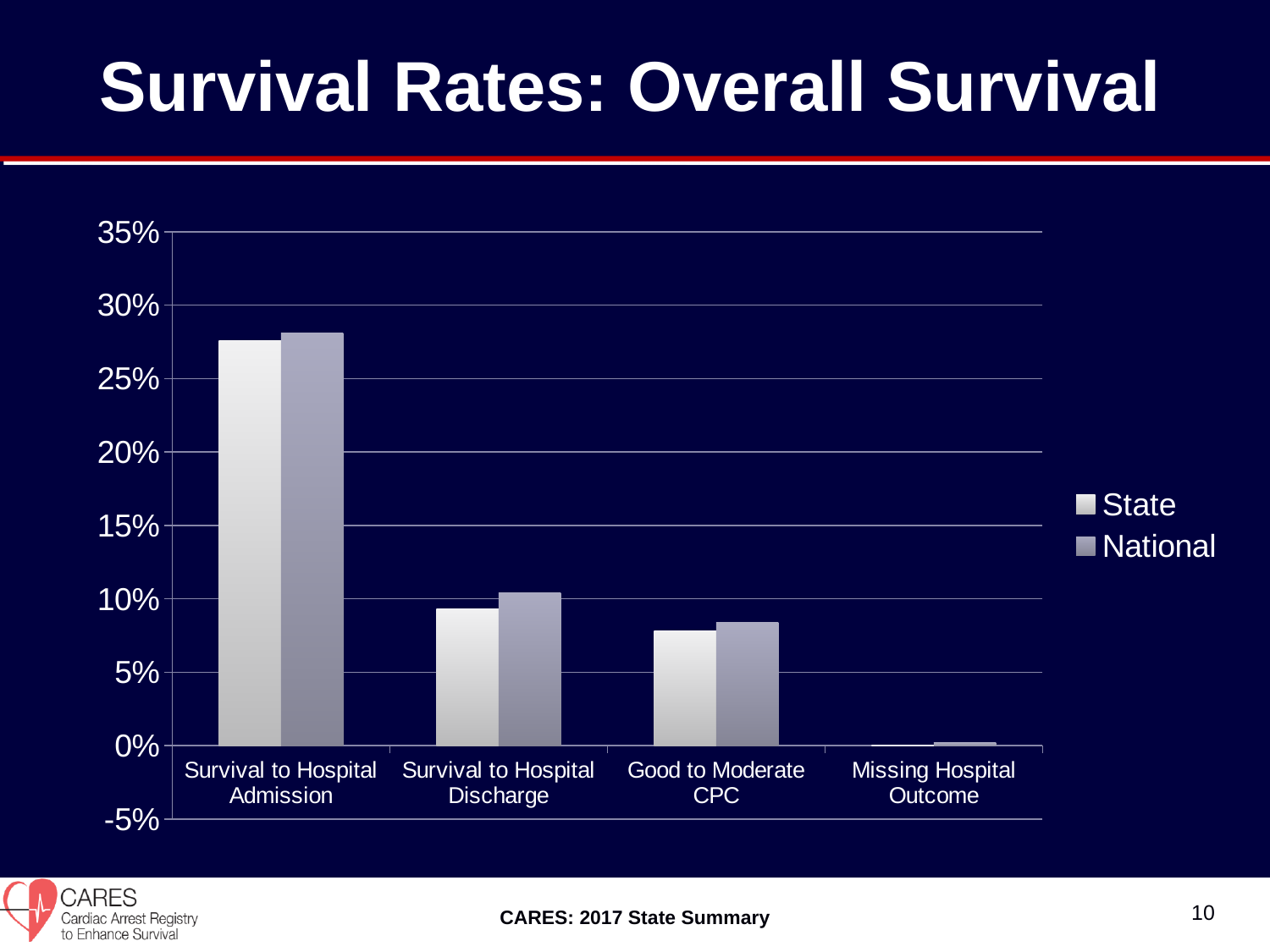
Which category has the lowest National value? Missing Hospital Outcome How many series does the legend list? 2 How many categories are shown on the x axis? 4 For Survival to Hospital Discharge, which is larger, the State value or the National value? National What kind of chart is shown on the slide? bar chart Is the National value for Survival to Hospital Admission greater or less than 30%? less What is the title of the chart on the slide? Survival Rates: Overall Survival Do the State values rise or fall moving from Survival to Hospital Admission to Missing Hospital Outcome along the x axis? fall Is the State value for Survival to Hospital Discharge greater or less than 10%? less Which category has the highest State value? Survival to Hospital Admission Is the State value for Survival to Hospital Admission greater or less than 25%? greater